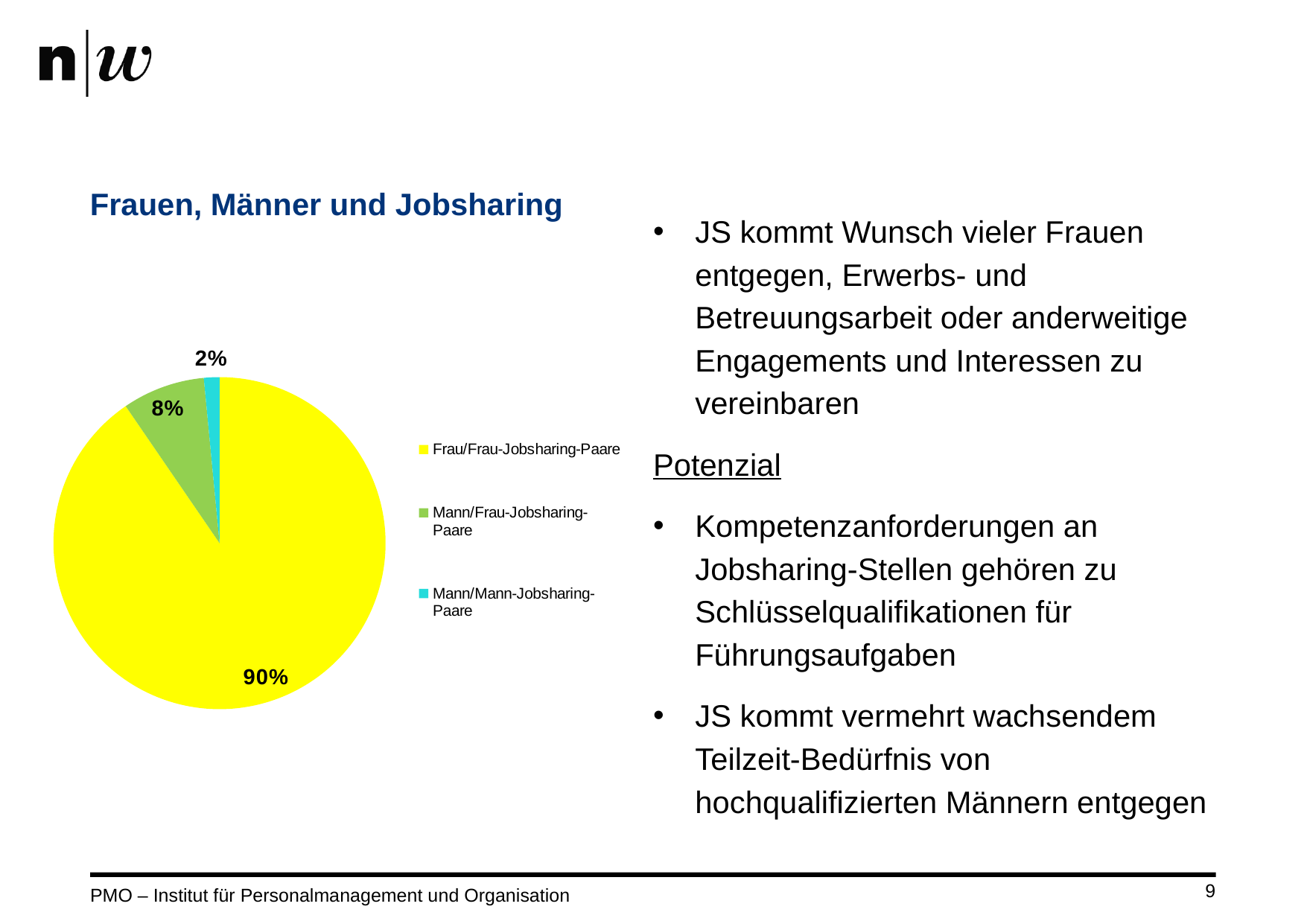
What share of the pie is Mann/Mann-Jobsharing-Paare? 2% What colour is the slice for Frau/Frau-Jobsharing-Paare? yellow What is the difference in percentage points between Mann/Frau-Jobsharing-Paare and Mann/Mann-Jobsharing-Paare? 6 Which category has the largest slice of the pie? Frau/Frau-Jobsharing-Paare What share of the pie is Frau/Frau-Jobsharing-Paare? 90% What share of the pie is Mann/Frau-Jobsharing-Paare? 8% What kind of chart is shown on the slide? pie chart What is the difference in percentage points between Frau/Frau-Jobsharing-Paare and Mann/Frau-Jobsharing-Paare? 82 How many categories does the pie chart have? 3 Which is larger: the share for Mann/Frau-Jobsharing-Paare or for Mann/Mann-Jobsharing-Paare? Mann/Frau-Jobsharing-Paare What is the title above the chart? Frauen, Männer und Jobsharing Which category has the smallest slice of the pie? Mann/Mann-Jobsharing-Paare